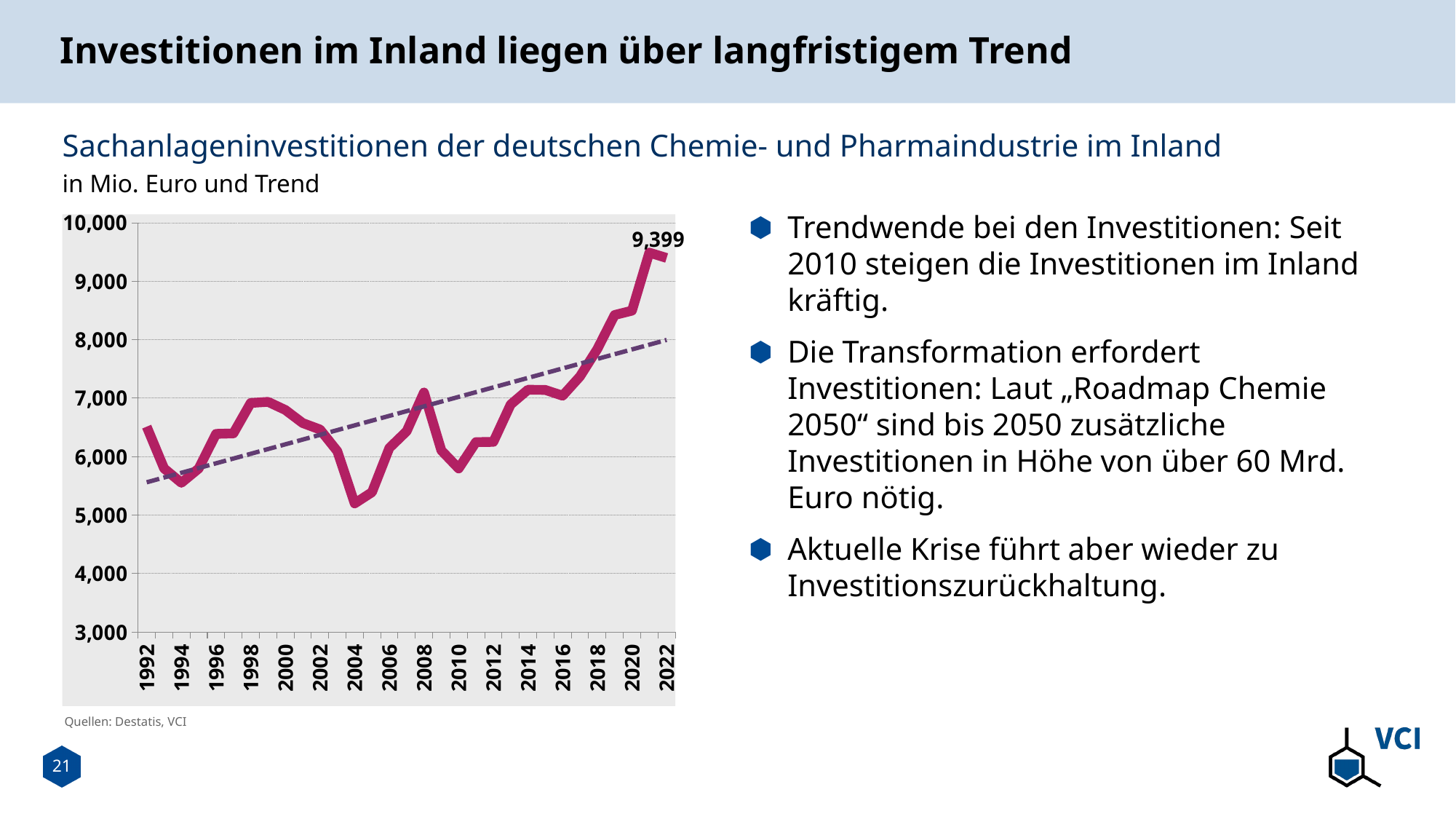
Is the value for 1992 greater or less than 6,000? greater Does the solid line overall rise or fall from 2010 to 2021? rise Is the value for 2004 greater or less than 6,000? less Is the value for 2016 greater or less than 6,000? greater What is the value printed as a data label on the chart? 9,399 Which year has the larger value, 2004 or 2020? 2020 What is the first year shown on the x axis? 1992 Which year shows the lowest value on the chart? 2004 What kind of chart is shown on the slide? line chart In what unit are the values on the chart given? Mio. Euro